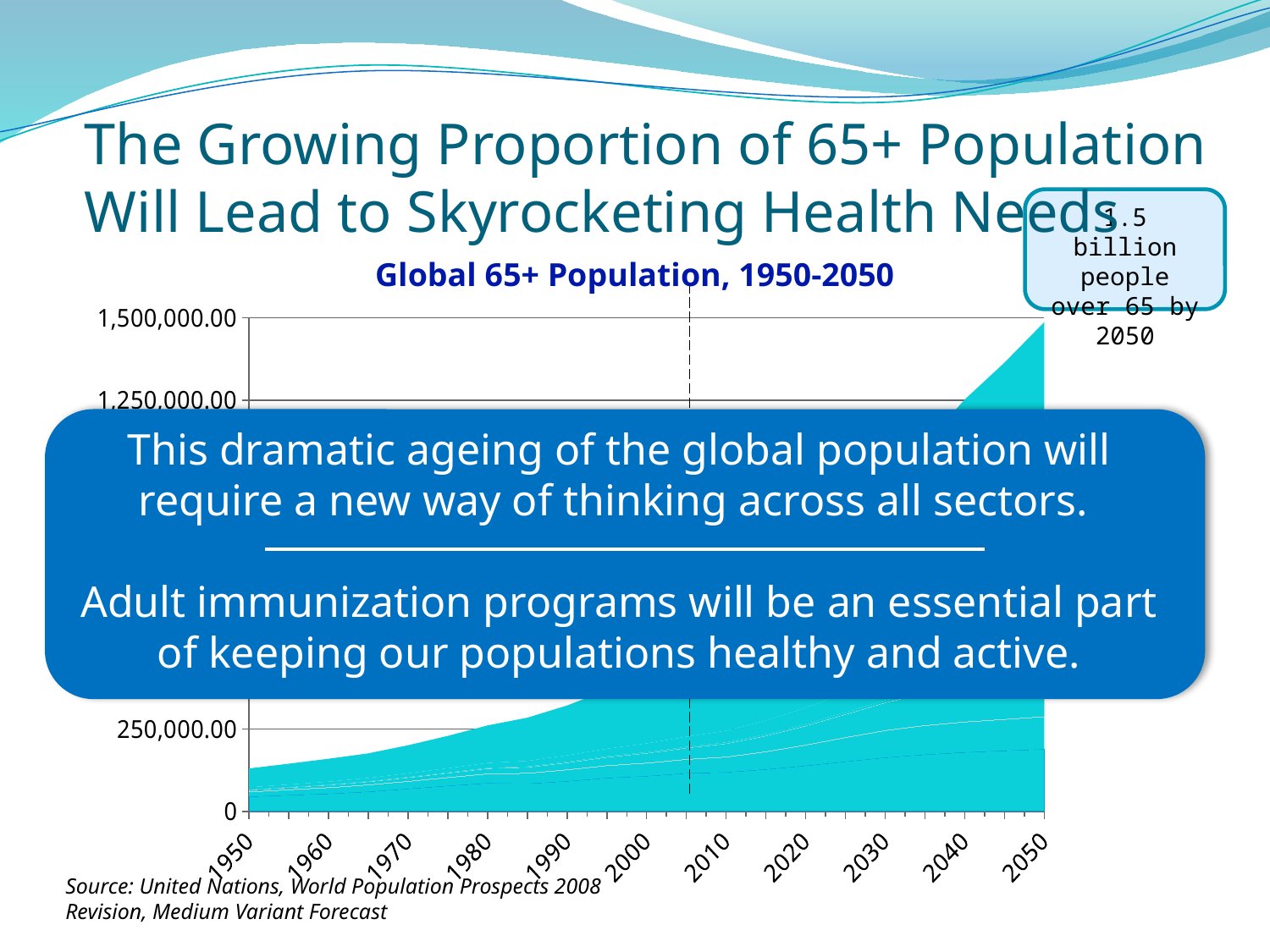
Which year on the x axis has the highest global 65+ population in the chart? 2050 Is the total value for 2050 greater or less than 1,250,000.00? greater Which year has the larger global 65+ population, 1960 or 1990? 1990 Does the global 65+ population rise or fall from 1950 to 2050 in the chart? rise What kind of chart is shown on the slide? area chart What source is cited for the chart data? United Nations, World Population Prospects 2008 Revision, Medium Variant Forecast Is the total value for 1950 greater or less than 250,000.00? less How many year labels are shown along the x axis of the chart? 11 What is the title of the chart on the slide? Global 65+ Population, 1950-2050 Which year on the x axis has the lowest global 65+ population in the chart? 1950 Which year has the larger global 65+ population, 1950 or 2050? 2050